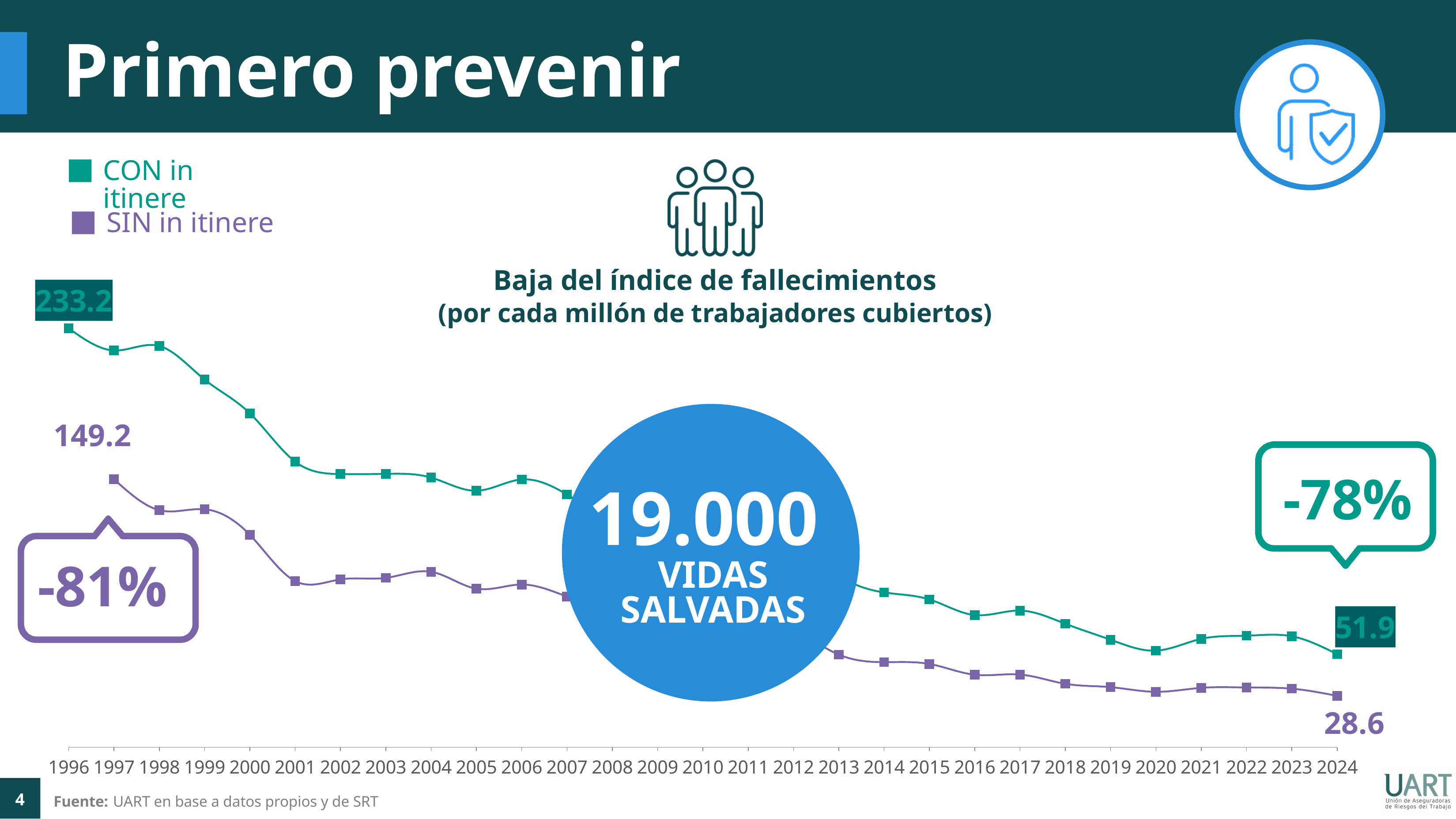
What is the difference between the CON in itinere and SIN in itinere values in 2024? 23.3 In 2024, which series has the higher value, CON in itinere or SIN in itinere? CON in itinere How many years are shown on the x axis? 29 What is the value of the CON in itinere series in 2024? 51.9 What is the value of the SIN in itinere series in 2024? 28.6 How many series does the legend list? 2 By how much did the CON in itinere value fall from 1996 (233.2) to 2024 (51.9)? 181.3 What is the value of the CON in itinere series in 1996? 233.2 What is the first labelled value of the SIN in itinere series? 149.2 What percentage change is shown in the callout next to the SIN in itinere series? -81% Do the values of the CON in itinere series rise or fall from 1996 to 2024? Fall What kind of chart is shown on the slide? Line chart